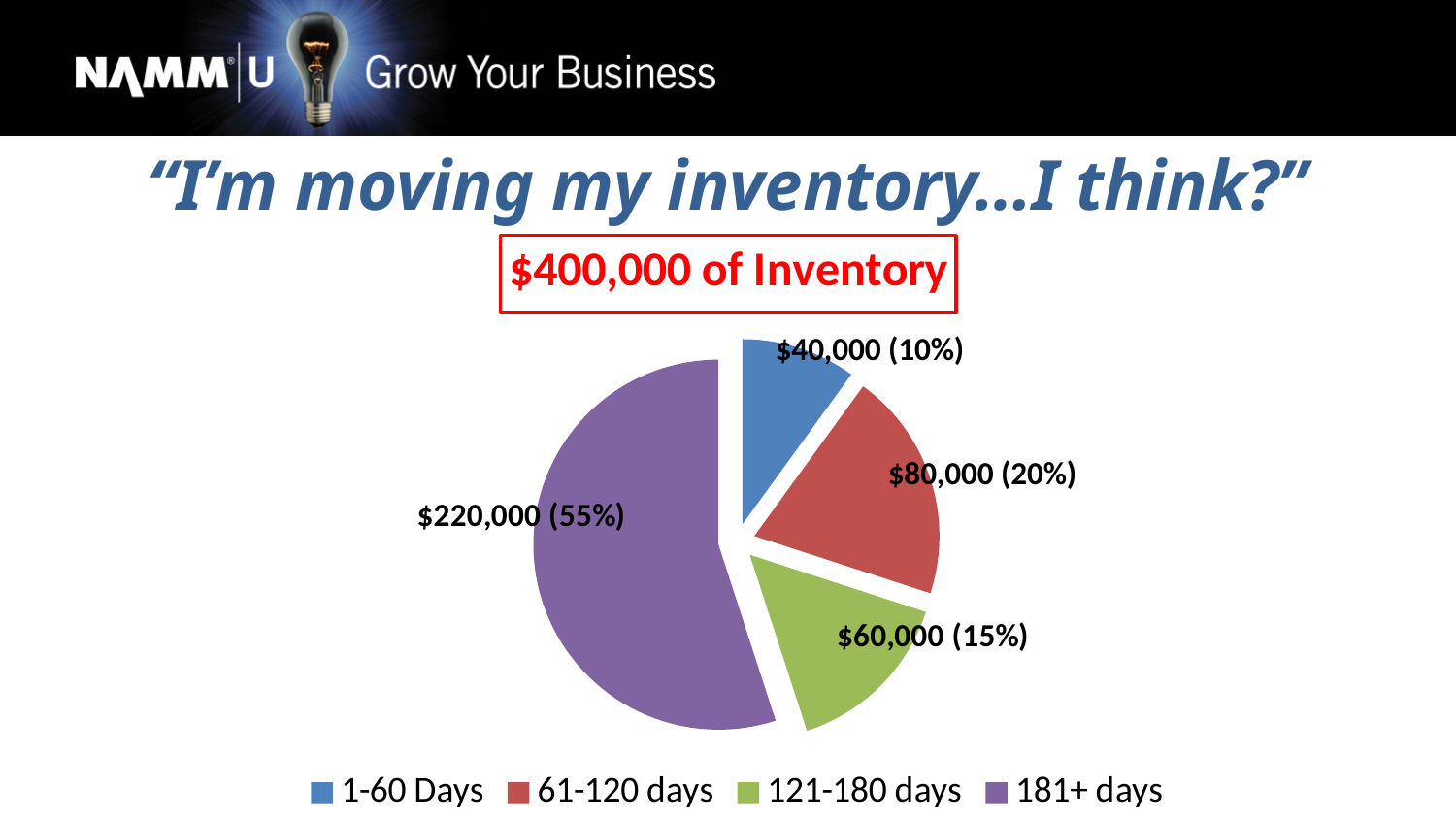
What is the inventory value for the 1-60 Days slice? $40,000 How many categories does the legend list? 4 What is the inventory value for the 61-120 days slice? $80,000 Which is larger, the 61-120 days slice or the 1-60 Days slice? 61-120 days What type of chart is shown on the slide? Pie chart Which category has the largest slice of the pie? 181+ days What share of the pie does the 181+ days slice represent? 55% What is the inventory value for the 121-180 days slice? $60,000 What share of the pie does the 121-180 days slice represent? 15% Which category has the smallest slice of the pie? 1-60 Days What is the difference in inventory value between the 61-120 days slice and the 121-180 days slice? $20,000 What is the inventory value for the 181+ days slice? $220,000